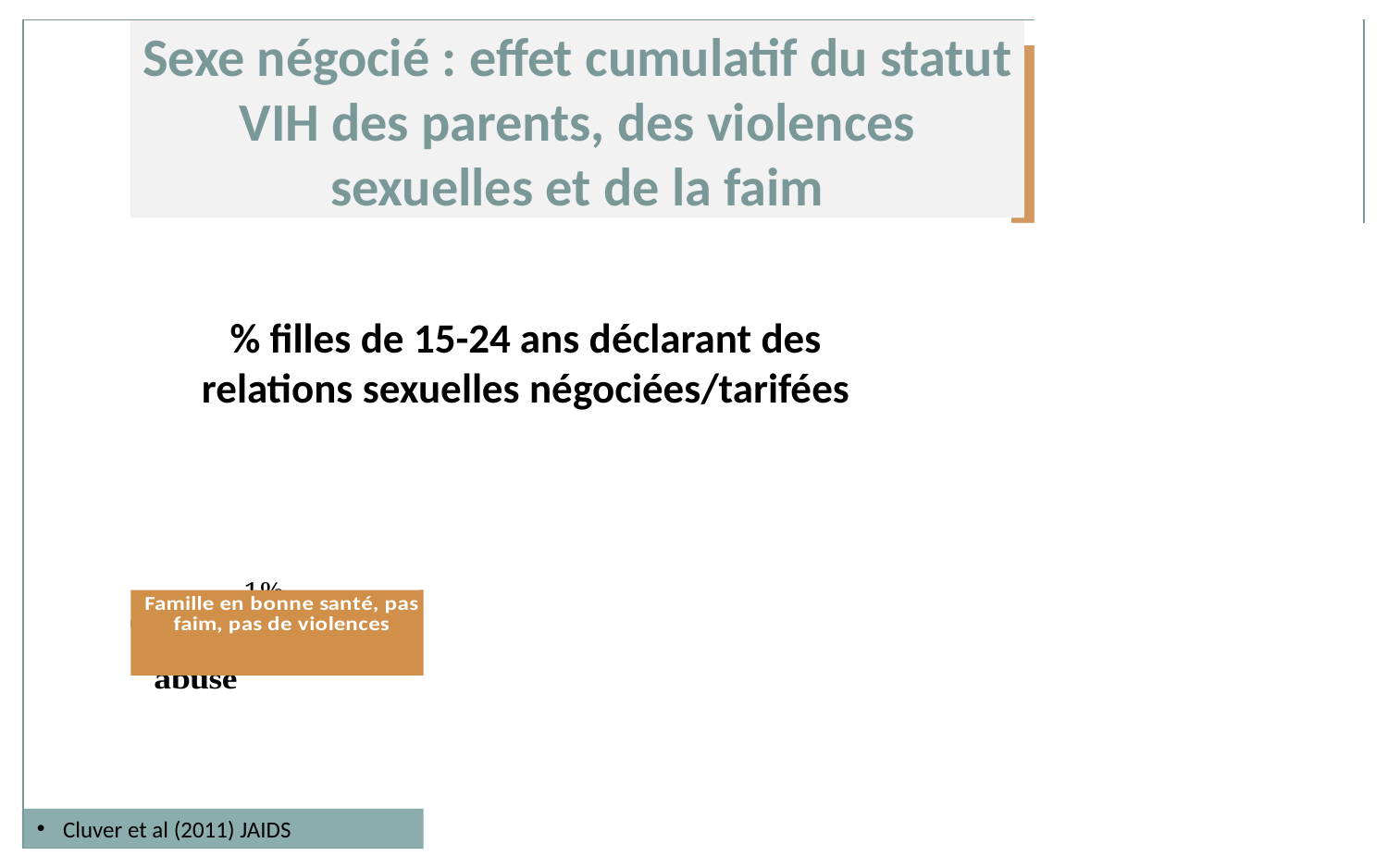
What is the label of the category shown in the orange box on the chart? Famille en bonne santé, pas faim, pas de violences What is the title of the chart on the slide? % filles de 15-24 ans déclarant des relations sexuelles négociées/tarifées What value is shown for the category "Famille en bonne santé, pas faim, pas de violences"? 1%